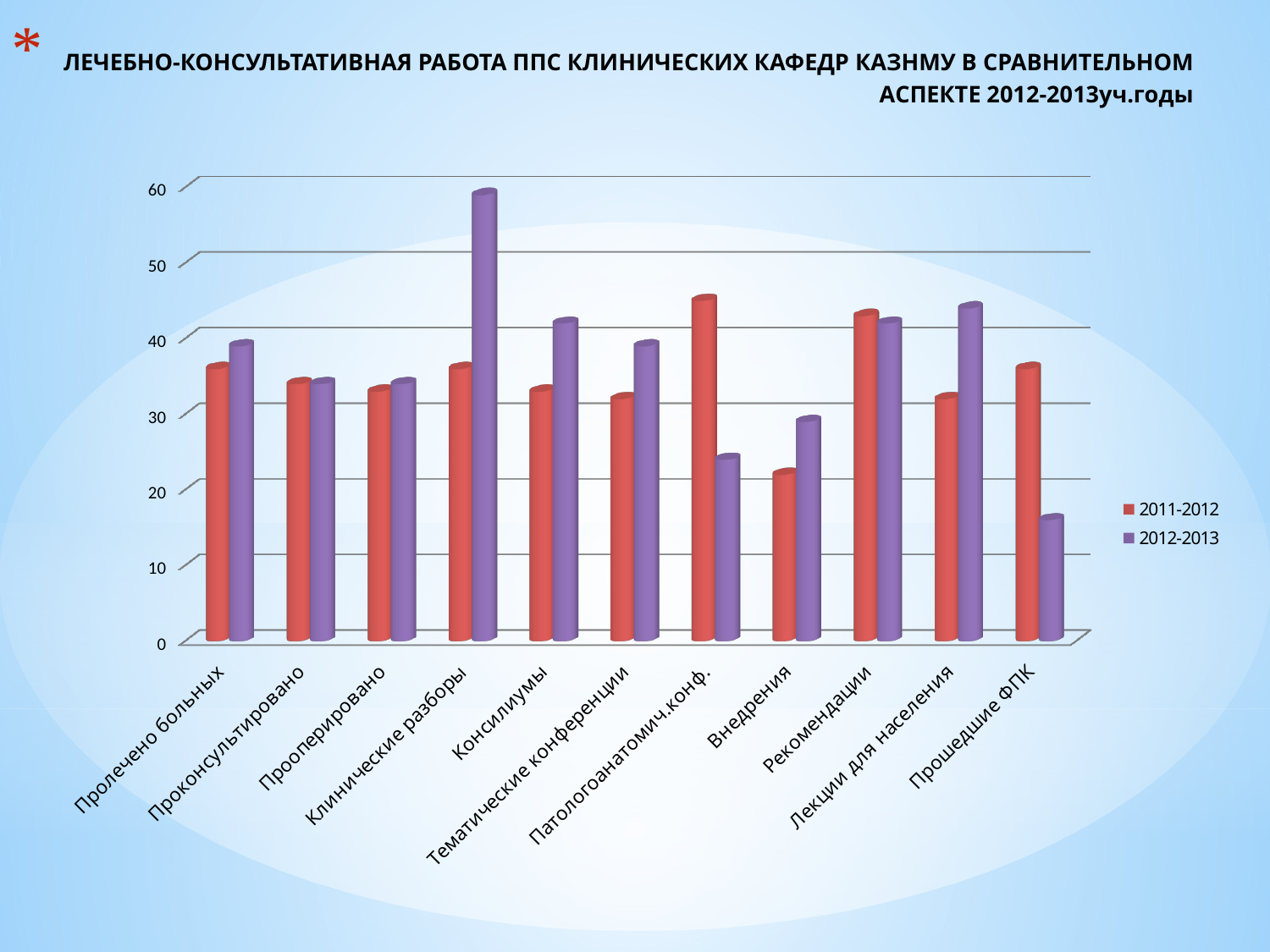
Is the 2012-2013 value for Патологоанатомич.конф. greater or less than 30? less How many series does the legend list? 2 Which category has the lowest value for the 2012-2013 series? Прошедшие ФПК Which category has the lowest value for the 2011-2012 series? Внедрения For Лекции для населения, which series has the larger value, 2011-2012 or 2012-2013? 2012-2013 Is the 2012-2013 value for Прошедшие ФПК greater or less than 20? less Is the 2011-2012 value for Патологоанатомич.конф. greater or less than 40? greater For Прошедшие ФПК, which series has the larger value, 2011-2012 or 2012-2013? 2011-2012 What kind of chart is shown on the slide? bar chart Which category has the highest value for the 2012-2013 series? Клинические разборы How many categories are shown on the x axis? 11